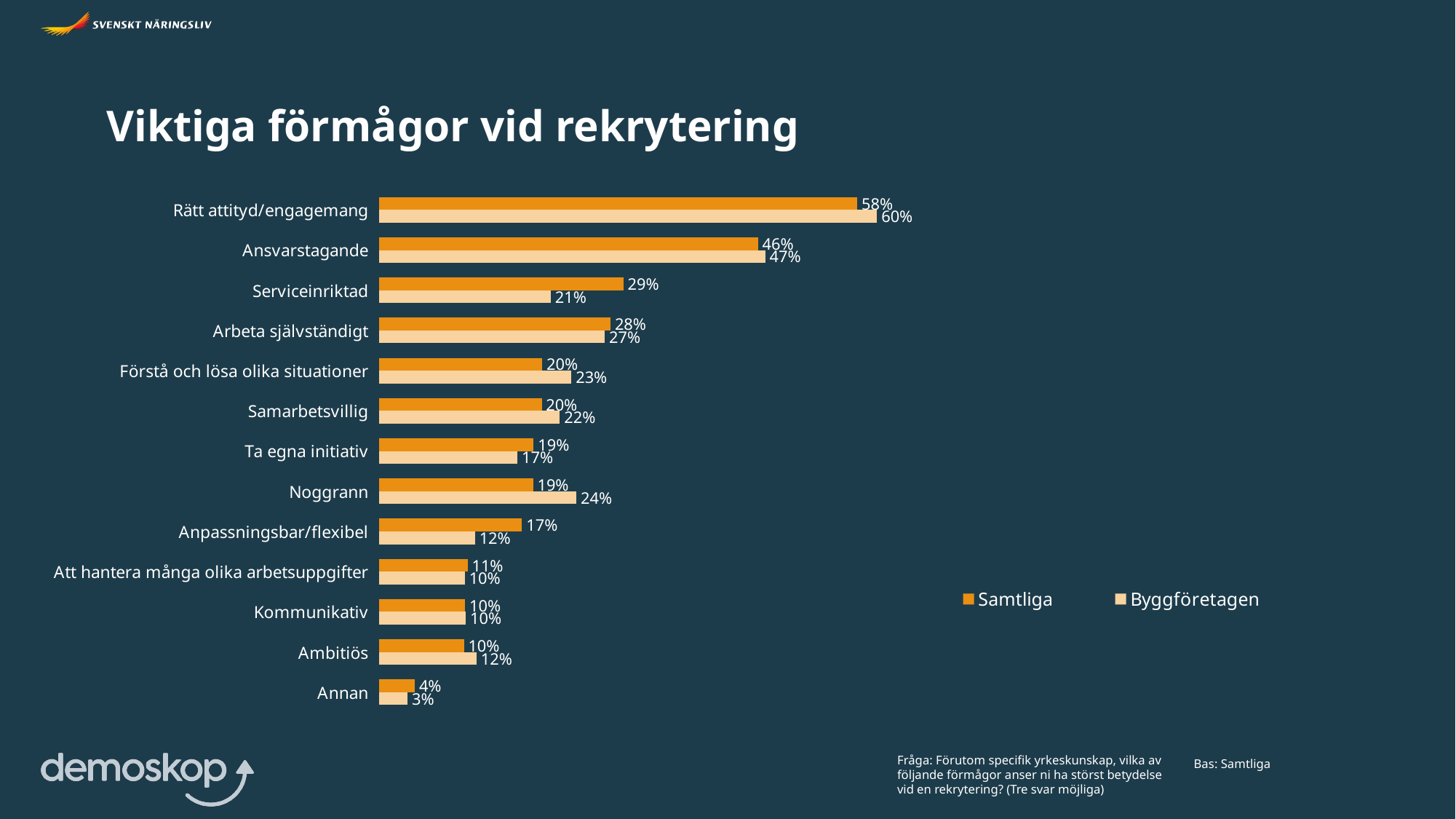
What is the value for Samtliga for Rätt attityd/engagemang? 58% Which category has the highest value for Byggföretagen? Rätt attityd/engagemang For Anpassningsbar/flexibel, which series has the larger value, Samtliga or Byggföretagen? Samtliga What is the difference between the Byggföretagen and Samtliga values for Noggrann? 5% What is the value for Byggföretagen for Serviceinriktad? 21% How many series does the legend list? 2 What is the value for Byggföretagen for Noggrann? 24% What kind of chart is shown on the slide? Bar chart What is the difference between the Samtliga and Byggföretagen values for Serviceinriktad? 8% Which category has the lowest value for Samtliga? Annan How many categories are shown in the chart? 13 What is the title of the chart on the slide? Viktiga förmågor vid rekrytering